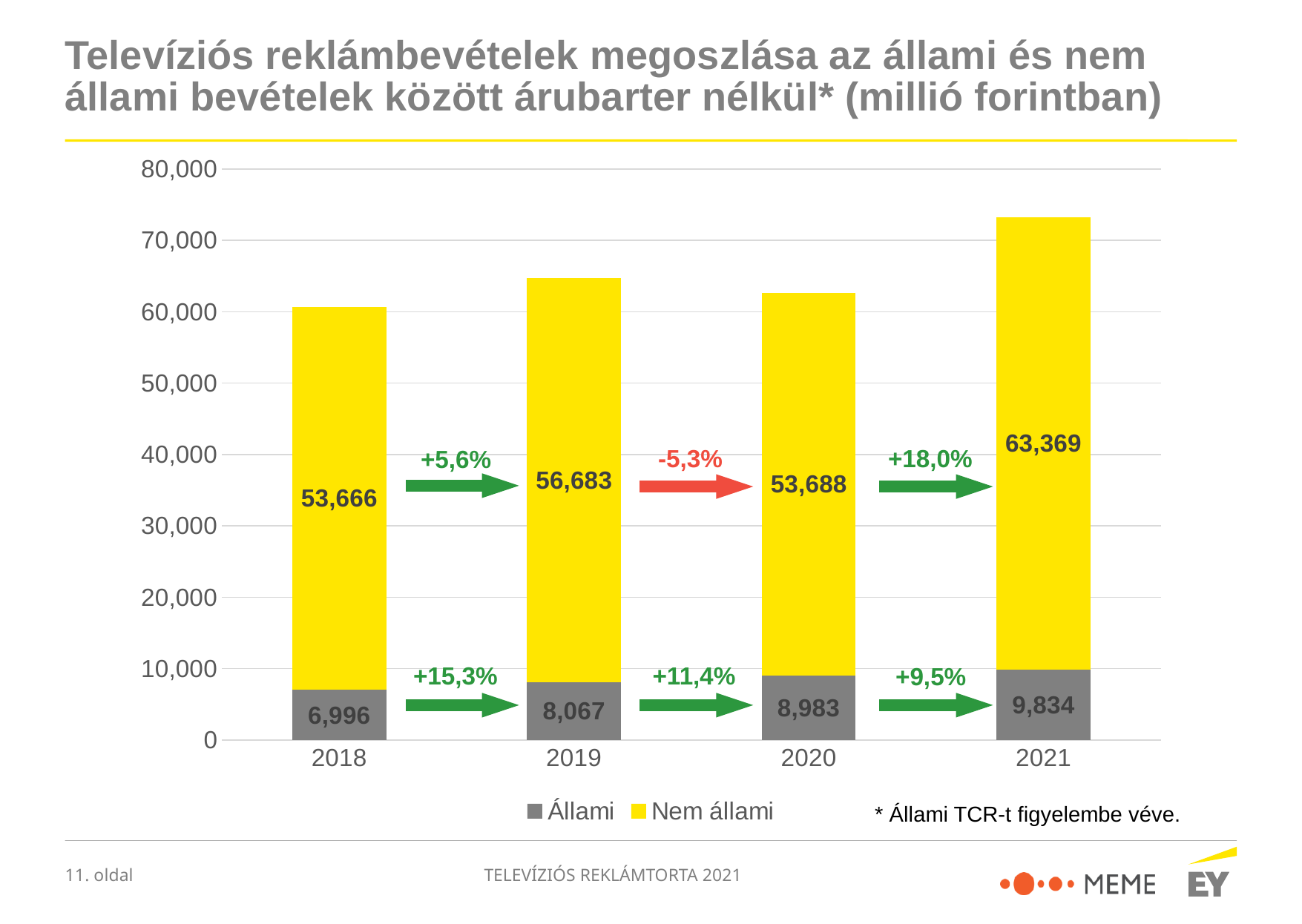
In which year is the Nem állami value lowest? 2018 How many series does the legend list? 2 What is the difference between the Nem állami values for 2021 and 2020? 9,681 What is the value for Nem állami in 2020? 53,688 Which is larger, the Nem állami value for 2019 or for 2020? 2019 How many years are shown on the x axis? 4 What is the total of the stacked bar for 2021? 73,203 What is the value for Állami in 2018? 6,996 In which year is the Állami value highest? 2021 What is the total of the stacked bar for 2018? 60,662 What is the value for Nem állami in 2021? 63,369 Does the Állami value rise or fall from 2018 to 2021? rise